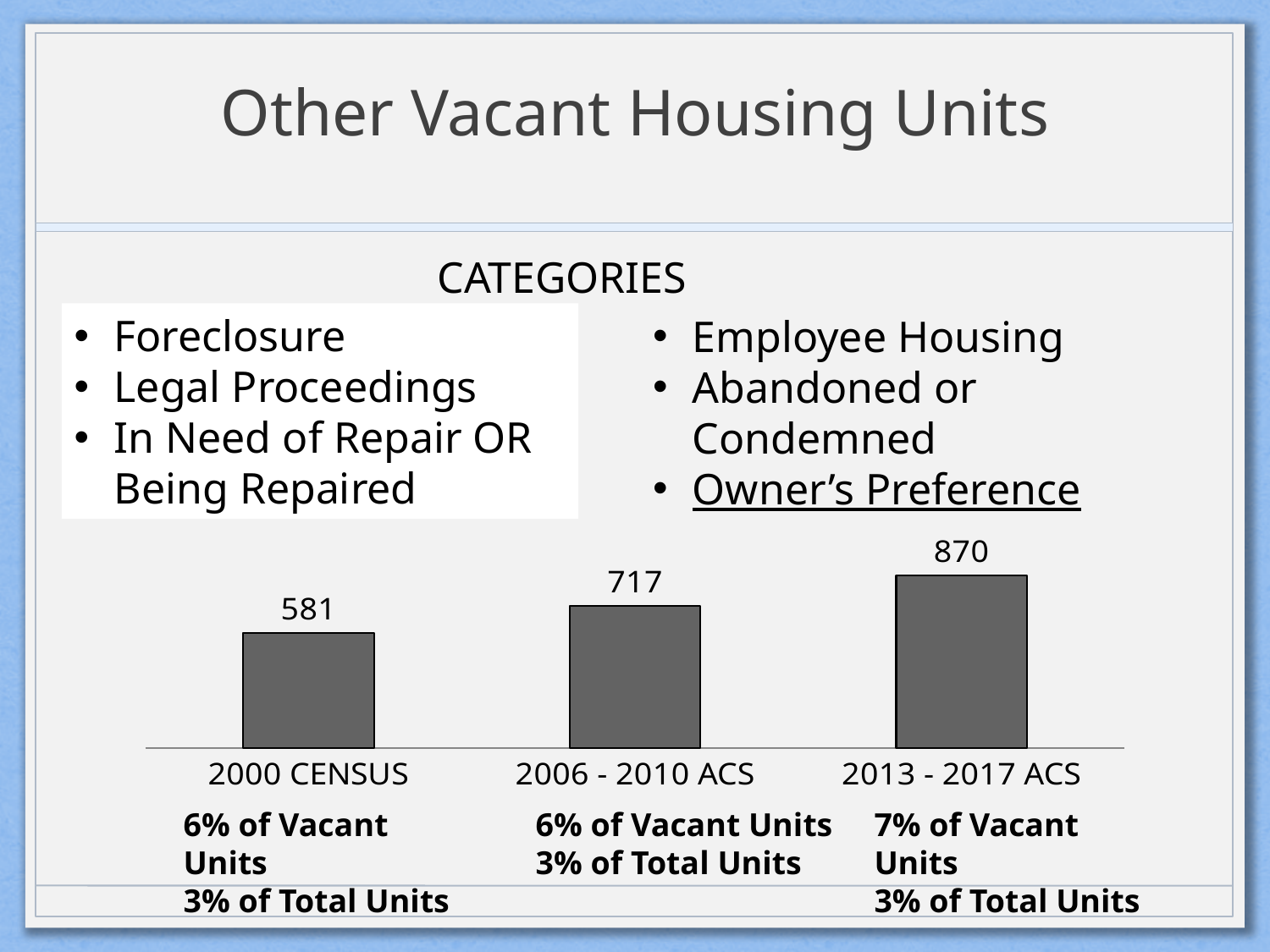
What is the value for 2000 CENSUS? 581 How many categories are shown on the x axis? 3 What is the value for 2013 - 2017 ACS? 870 Which category has the lowest value? 2000 CENSUS Which is larger, the value for 2006 - 2010 ACS or the value for 2013 - 2017 ACS? 2013 - 2017 ACS What is the value for 2006 - 2010 ACS? 717 Which category has the highest value? 2013 - 2017 ACS What kind of chart is shown on the slide? bar chart Do the values rise or fall from 2000 CENSUS to 2013 - 2017 ACS? rise What is the difference between the values for 2006 - 2010 ACS and 2000 CENSUS? 136 What is the title of the slide containing the chart? Other Vacant Housing Units What is the difference between the values for 2013 - 2017 ACS and 2000 CENSUS? 289